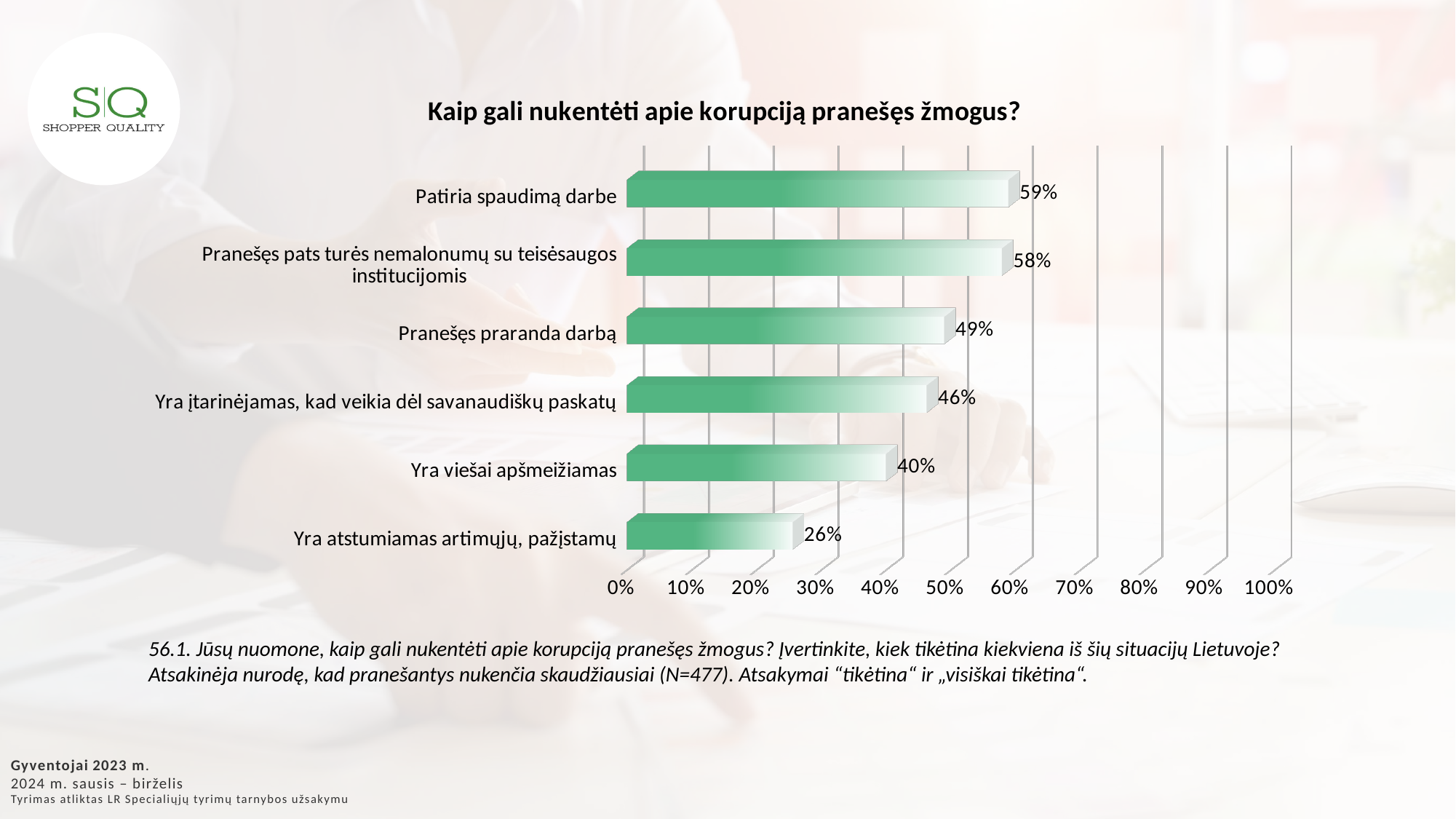
How many categories are shown in the chart? 6 What is the title of the chart? Kaip gali nukentėti apie korupciją pranešęs žmogus? What is the value for "Pranešęs praranda darbą"? 49% Which is larger: the value for "Yra viešai apšmeižiamas" or the value for "Yra įtarinėjamas, kad veikia dėl savanaudiškų paskatų"? Yra įtarinėjamas, kad veikia dėl savanaudiškų paskatų What is the value for "Yra atstumiamas artimųjų, pažįstamų"? 26% What kind of chart is shown on the slide? Bar chart Which category has the lowest value? Yra atstumiamas artimųjų, pažįstamų What is the difference between the values for "Patiria spaudimą darbe" and "Yra atstumiamas artimųjų, pažįstamų"? 33% What is the value for "Patiria spaudimą darbe"? 59% What is the difference between the values for "Pranešęs praranda darbą" and "Yra įtarinėjamas, kad veikia dėl savanaudiškų paskatų"? 3% What is the value for "Yra viešai apšmeižiamas"? 40% Which category has the highest value? Patiria spaudimą darbe